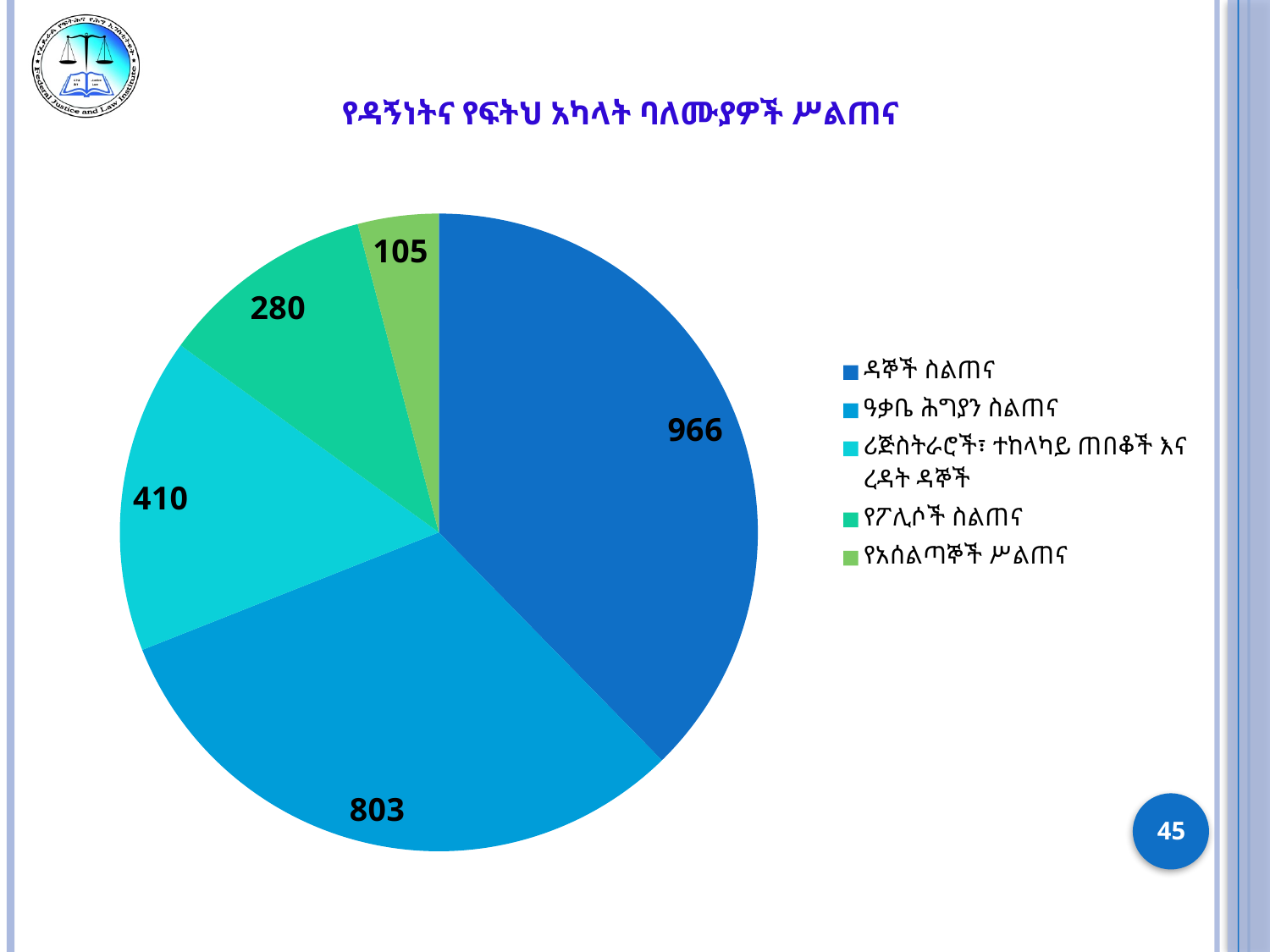
How many categories does the pie chart have? 5 What is the value for የአሰልጣኞች ሥልጠና? 105 Which category has the largest slice of the pie? ዳኞች ስልጠና What is the difference between the values for ዳኞች ስልጠና and ዓቃቤ ሕግያን ስልጠና? 163 What is the value for ዳኞች ስልጠና? 966 What is the value for የፖሊሶች ስልጠና? 280 Which is larger, the value for ሪጅስትራሮች፣ ተከላካይ ጠበቆች እና ረዳት ዳኞች or the value for የፖሊሶች ስልጠና? ሪጅስትራሮች፣ ተከላካይ ጠበቆች እና ረዳት ዳኞች Which category has the smallest slice of the pie? የአሰልጣኞች ሥልጠና What type of chart is shown on the slide? pie chart What is the title of the chart? የዳኝነትና የፍትህ አካላት ባለሙያዎች ሥልጠና What is the value for ሪጅስትራሮች፣ ተከላካይ ጠበቆች እና ረዳት ዳኞች? 410 What is the value for ዓቃቤ ሕግያን ስልጠና? 803